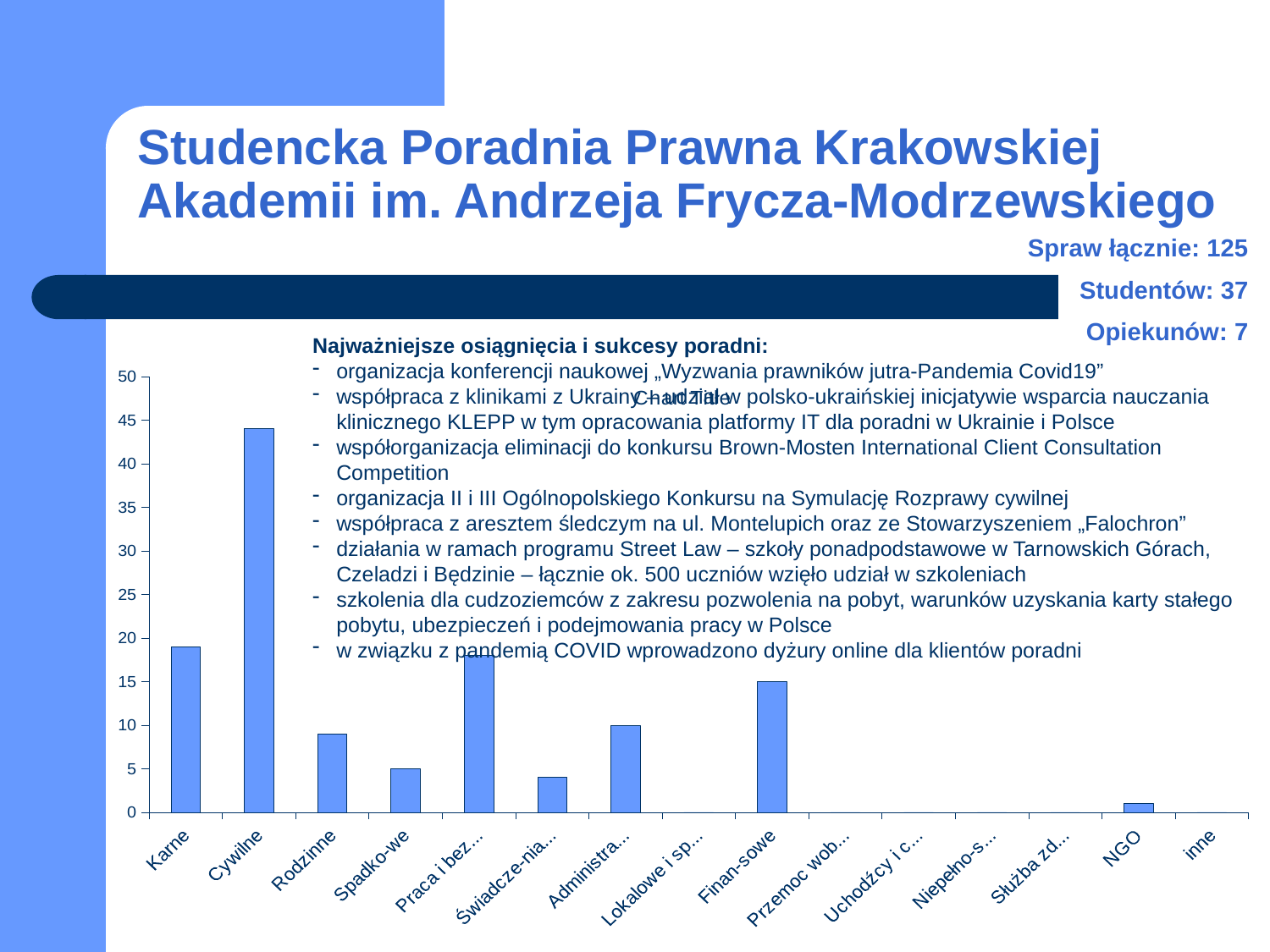
What kind of chart is shown on the slide? bar chart How many categories are shown on the x axis of the chart? 15 What is the difference between the values for Finan-sowe and Spadko-we? 10 Which category has the highest bar in the chart? Cywilne What is the value for Finan-sowe? 15 Which is larger, the value for Finan-sowe or the value for Administra...? Finan-sowe Is the value for Karne greater or less than 15? greater What is the value for Administra...? 10 Is the value for NGO greater or less than 5? less Is the value for Rodzinne greater or less than 10? less What is the value for Spadko-we? 5